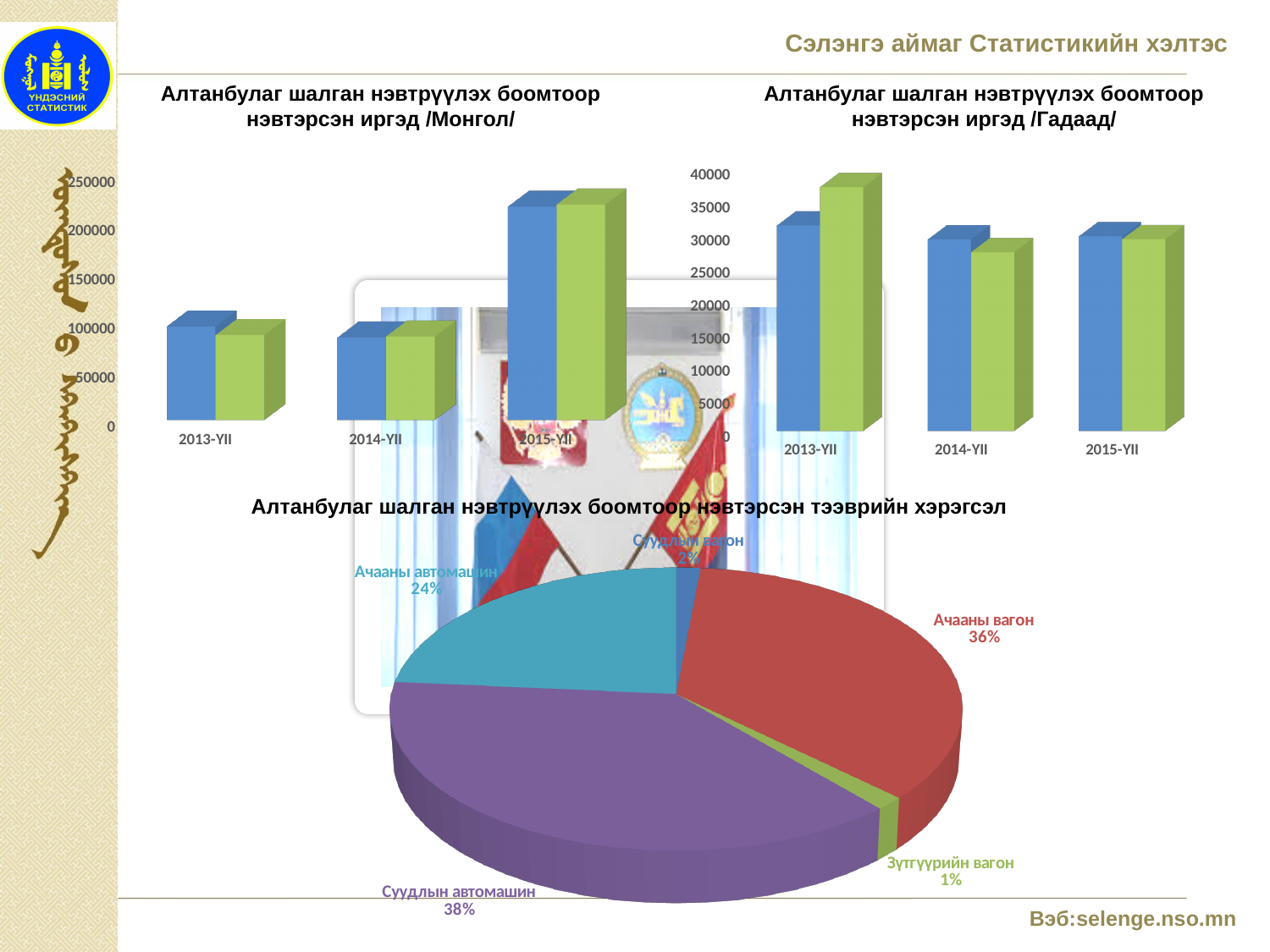
In the pie chart at the bottom of the slide, which category has the smallest share? Зүтгүүрийн вагон How many year categories are shown on the x axis of the chart titled "Алтанбулаг шалган нэвтрүүлэх боомтоор нэвтэрсэн иргэд /Гадаад/"? 3 In the pie chart titled "Алтанбулаг шалган нэвтрүүлэх боомтоор нэвтэрсэн тээврийн хэрэгсэл", what share does "Суудлын автомашин" have? 38% In the chart titled "Алтанбулаг шалган нэвтрүүлэх боомтоор нэвтэрсэн иргэд /Монгол/", which year has the tallest bars? 2015-YII In the pie chart at the bottom of the slide, what percentage is shown for "Ачааны вагон"? 36% In the pie chart at the bottom of the slide, what is the difference in percentage points between "Суудлын автомашин" and "Ачааны вагон"? 2 How many slices does the pie chart at the bottom of the slide have? 5 In the pie chart at the bottom of the slide, which category has the largest share? Суудлын автомашин What kind of chart is the chart titled "Алтанбулаг шалган нэвтрүүлэх боомтоор нэвтэрсэн иргэд /Монгол/"? bar chart In the pie chart at the bottom of the slide, what percentage is shown for "Ачааны автомашин"? 24% In the chart titled "Алтанбулаг шалган нэвтрүүлэх боомтоор нэвтэрсэн иргэд /Монгол/", is the value of the blue bar for 2015-YII greater or less than 150000? greater In the pie chart at the bottom of the slide, which is larger: "Ачааны автомашин" or "Суудлын вагон"? Ачааны автомашин